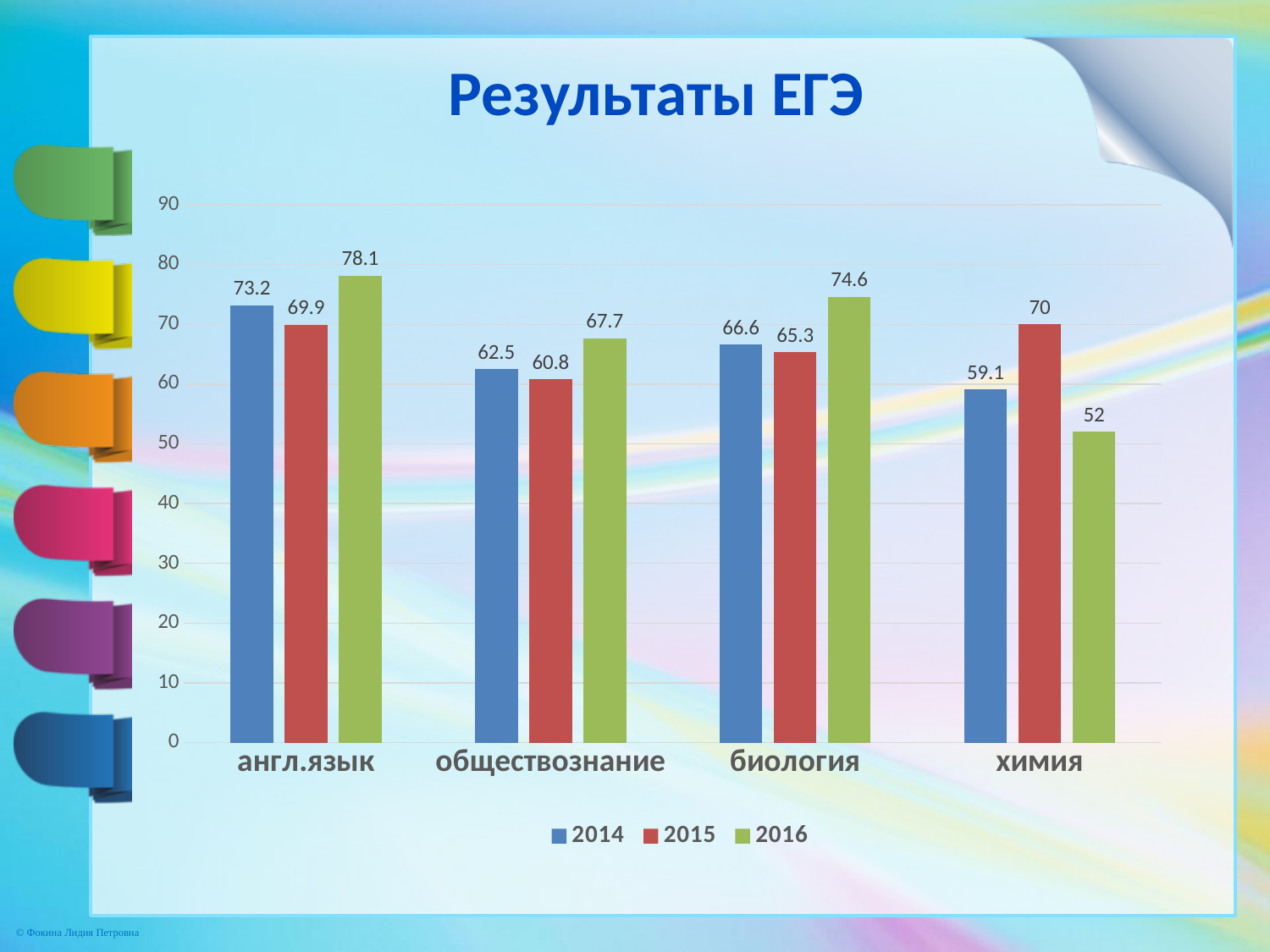
What kind of chart is shown on the slide? bar chart Is the value for обществознание in 2015 greater or less than 70? less Which subject has the highest value in 2016? англ.язык What is the difference between the 2016 and 2015 values for биология? 9.3 How many subjects are shown on the x axis? 4 What is the value for обществознание in 2014? 62.5 What is the value for химия in 2015? 70 What is the value for англ.язык in 2016? 78.1 How many series does the legend list? 3 What is the title of the chart? Результаты ЕГЭ Which is larger for химия: the 2014 value or the 2015 value? 2015 Which subject has the lowest value in 2016? химия